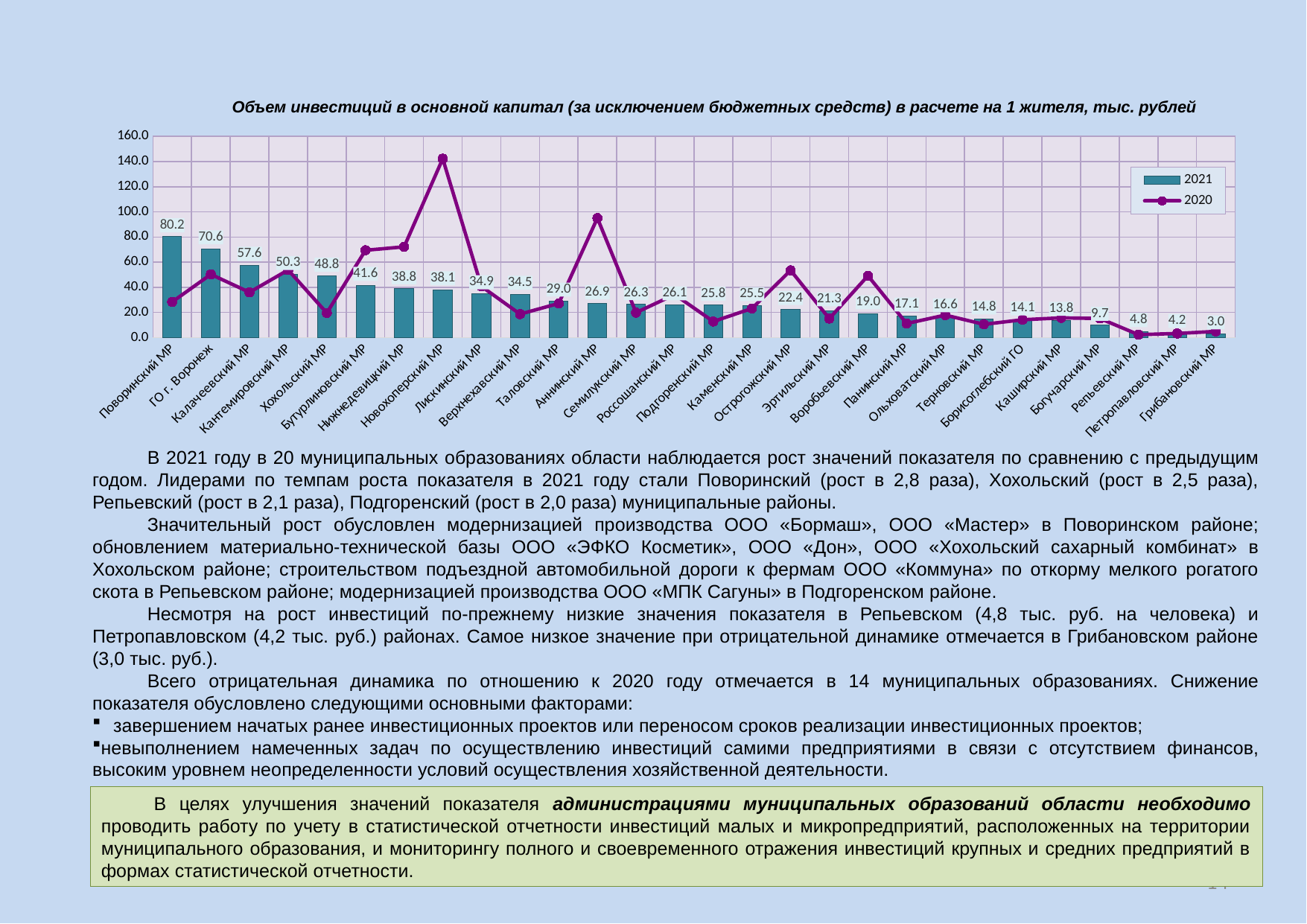
Which category has the highest 2021 value? Поворинский МР How many categories are shown on the x axis? 28 What is the 2021 value for Борисоглебский ГО? 14.1 What is the 2021 value for Поворинский МР? 80.2 Is the 2020 value for Новохоперский МР greater or less than 120.0? greater Which series is shown as a line rather than bars? 2020 Is the 2020 value for Аннинский МР greater or less than 80.0? greater Which has the larger 2021 value, Лискинский МР or Таловский МР? Лискинский МР What is the difference between the 2021 values for ГО г. Воронеж and Калачеевский МР? 13.0 How many series does the legend list? 2 What is the 2021 value for Хохольский МР? 48.8 Which category has the lowest 2021 value? Грибановский МР